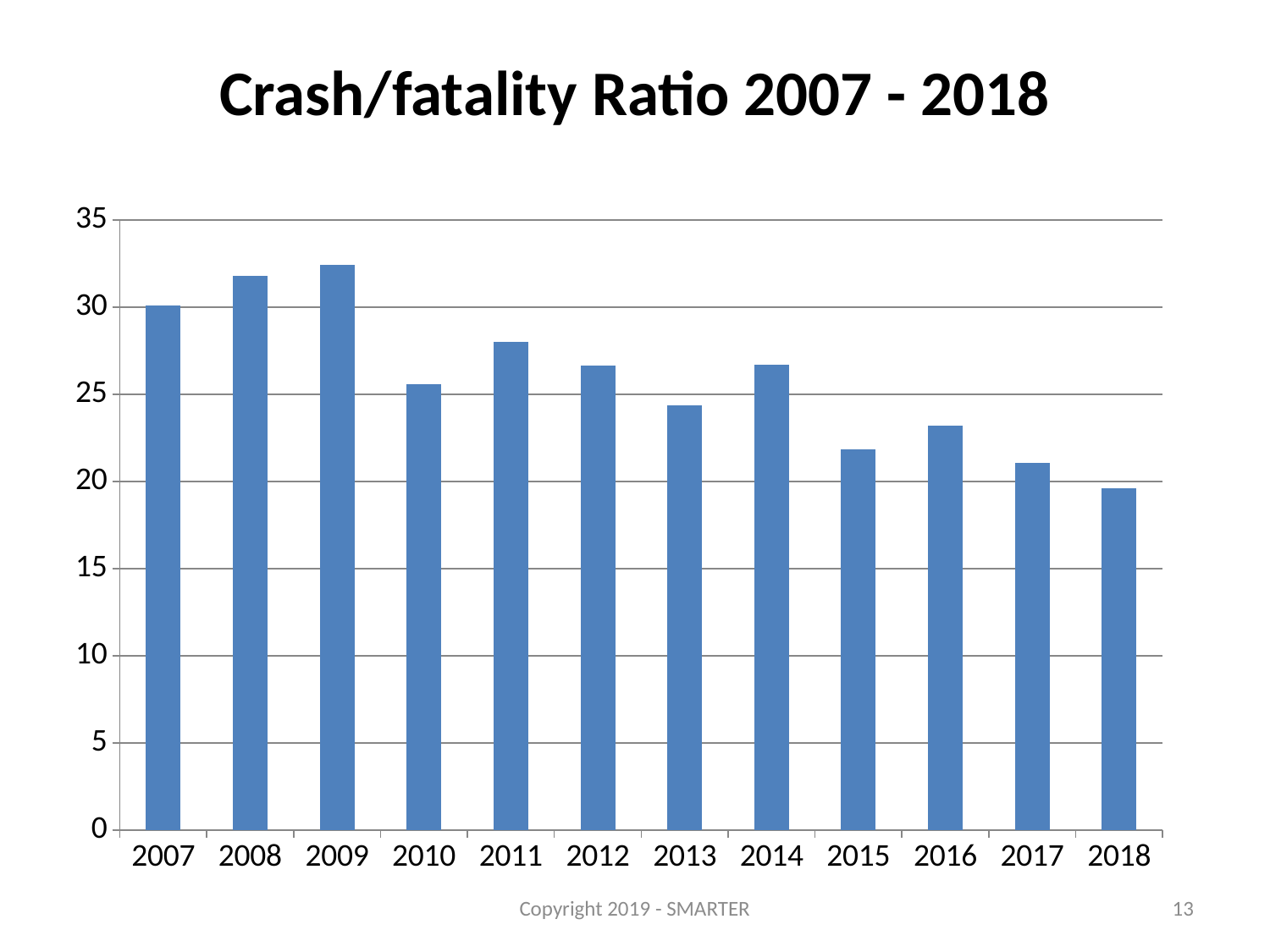
Is the value for 2018 greater or less than 20? less Which is larger, the value for 2008 or the value for 2010? 2008 Which year has the lowest crash/fatality ratio? 2018 Is the value for 2009 greater or less than 30? greater How many years are plotted on the x axis? 12 Is the value for 2011 greater or less than 25? greater What kind of chart is shown on the slide? bar chart Which is larger, the value for 2016 or the value for 2017? 2016 What is the title of the chart? Crash/fatality Ratio 2007 - 2018 Overall, do the values rise or fall from 2007 to 2018? fall Which year has the highest crash/fatality ratio? 2009